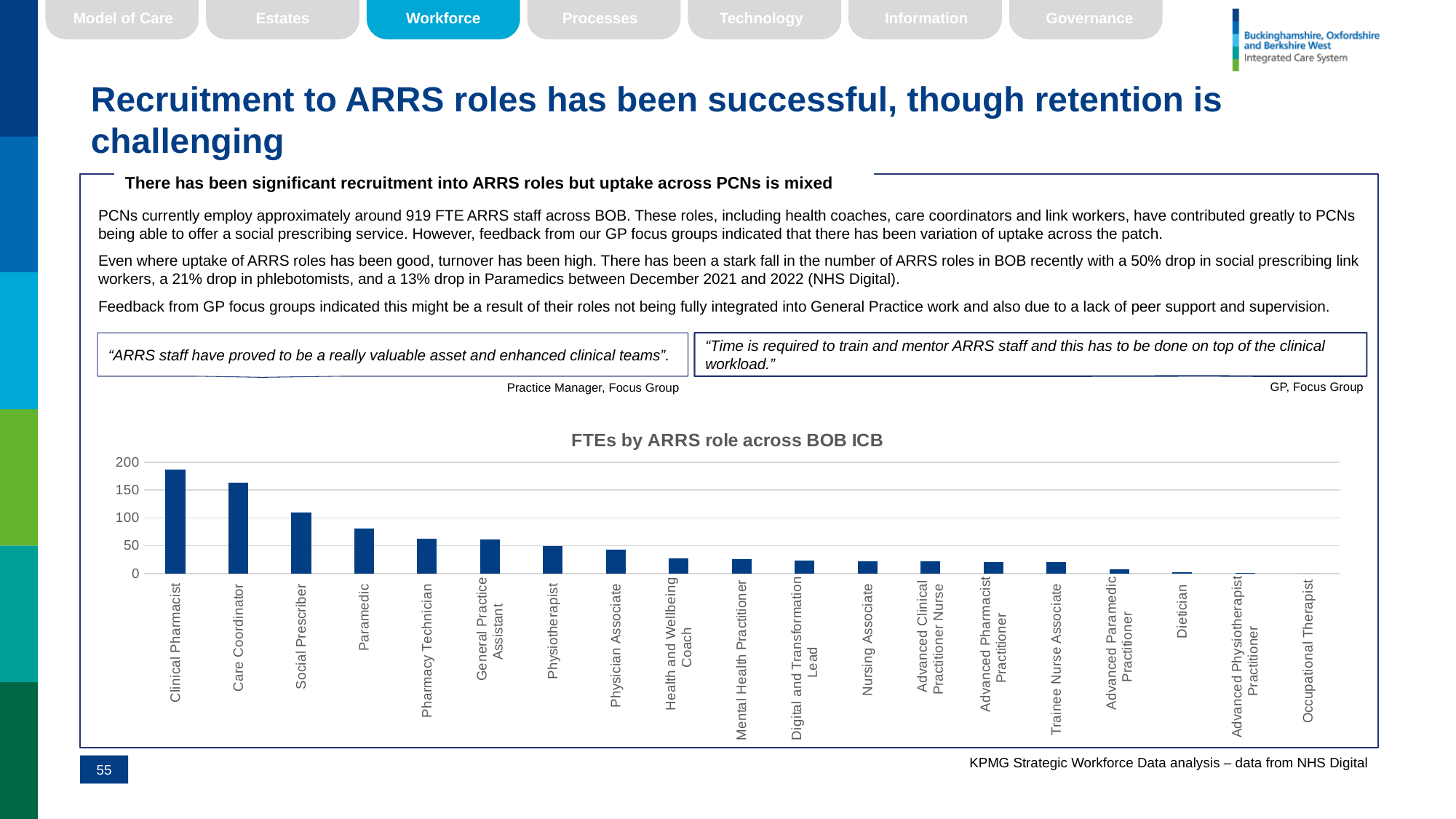
Which ARRS role has the highest number of FTEs in the chart? Clinical Pharmacist What is the title of the chart on the slide? FTEs by ARRS role across BOB ICB Is the value for Clinical Pharmacist greater or less than 150? greater Is the value for Social Prescriber greater or less than 100? greater What kind of chart is shown on the slide? Bar chart How many ARRS roles are shown on the x axis of the chart? 19 Which has more FTEs, Paramedic or Physiotherapist? Paramedic Which ARRS role has the lowest number of FTEs in the chart? Occupational Therapist Is the value for Paramedic greater or less than 100? less Do the bar values rise or fall moving from left to right along the x axis? Fall Which has more FTEs, Care Coordinator or Social Prescriber? Care Coordinator